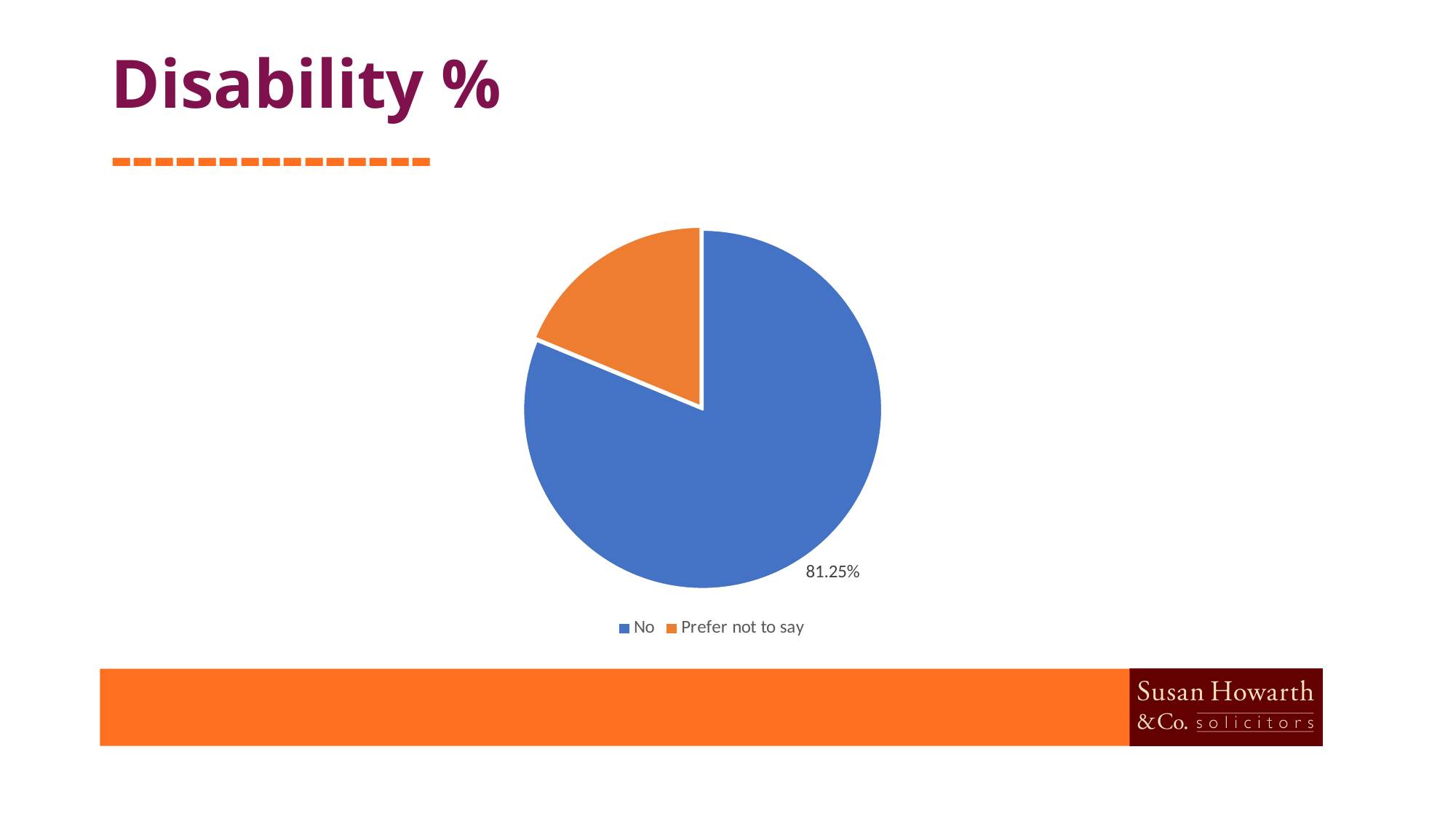
Is the share for "No" greater or less than 50%? greater What share of the pie does the "No" slice represent? 81.25% Which category has the largest slice in the pie chart? No What colour is the "Prefer not to say" slice in the pie chart? orange Which category has the smallest slice in the pie chart? Prefer not to say How many entries does the legend of the pie chart list? 2 What is the title of the slide containing the pie chart? Disability % What percentage is shown for the "No" slice of the pie chart? 81.25% Which slice is larger, "No" or "Prefer not to say"? No What kind of chart is shown on the slide? pie chart How many slices does the pie chart have? 2